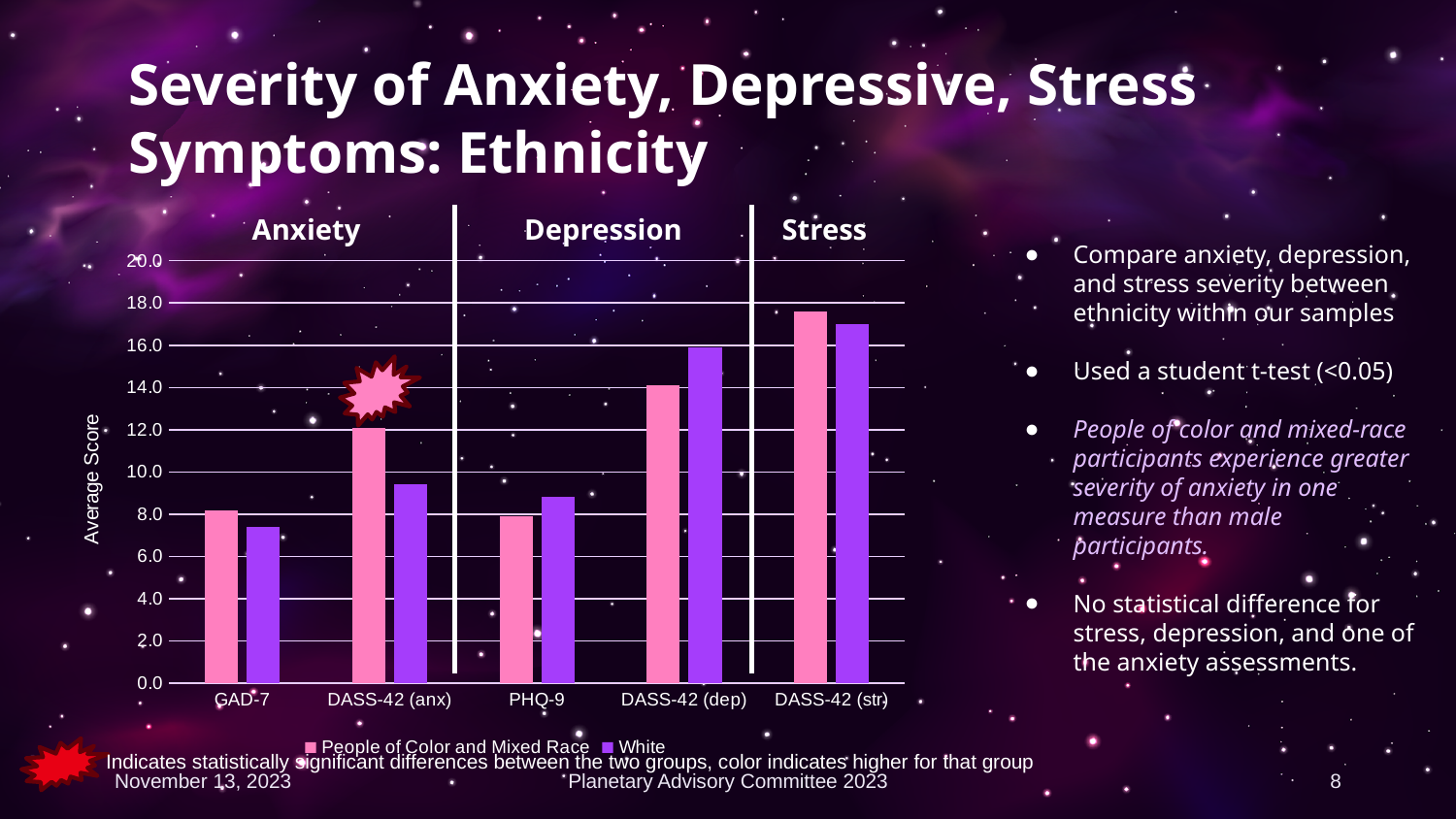
Is the value for People of Color and Mixed Race in DASS-42 (str) greater or less than 16.0? greater How many series does the chart's legend list? 2 What kind of chart is shown on the slide? bar chart For DASS-42 (dep), which group has the larger value: People of Color and Mixed Race or White? White Is the value for White in DASS-42 (dep) greater or less than 14.0? greater Which category has the highest bar in the chart? DASS-42 (str) How many categories are shown on the x axis of the chart? 5 For DASS-42 (anx), which group has the larger value: People of Color and Mixed Race or White? People of Color and Mixed Race Is the value for White in DASS-42 (anx) greater or less than 10.0? less Which category has the lowest value for the White series? GAD-7 What is the label of the chart's vertical axis? Average Score For GAD-7, which group has the larger value: People of Color and Mixed Race or White? People of Color and Mixed Race